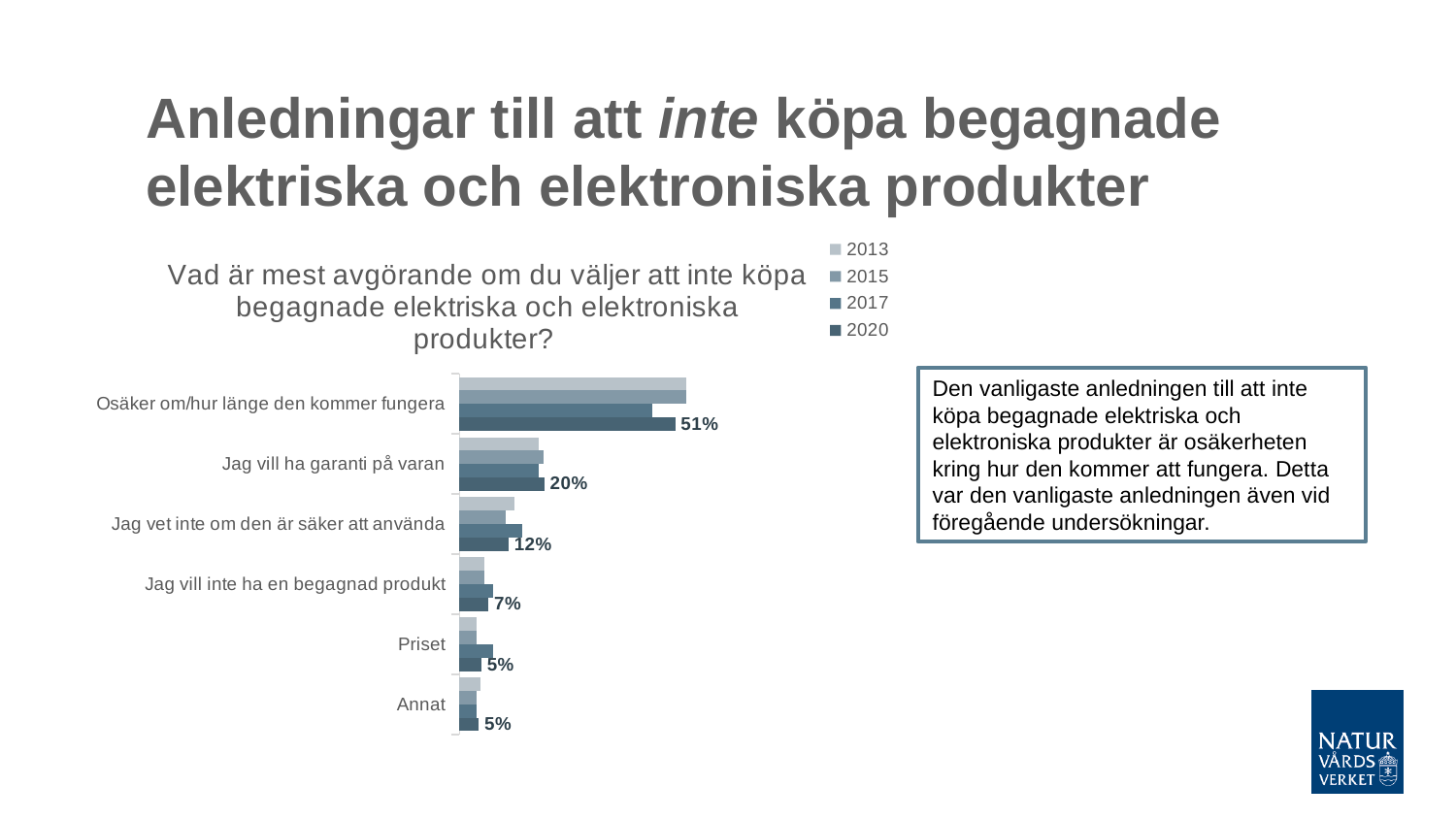
What is the 2020 value for "Priset"? 5% Which category has the highest 2020 value? Osäker om/hur länge den kommer fungera What is the 2020 value for "Jag vet inte om den är säker att använda"? 12% What is the 2020 value for "Osäker om/hur länge den kommer fungera"? 51% How many categories are shown in the chart? 6 What kind of chart is shown on the slide? Bar chart Which has the larger 2020 value, "Jag vill ha garanti på varan" or "Jag vill inte ha en begagnad produkt"? Jag vill ha garanti på varan How many series does the legend list? 4 What is the difference between the 2020 values for "Osäker om/hur länge den kommer fungera" and "Jag vill ha garanti på varan"? 31% What is the difference between the 2020 values for "Jag vet inte om den är säker att använda" and "Jag vill inte ha en begagnad produkt"? 5% Which years are listed in the chart legend? 2013, 2015, 2017, 2020 What is the 2020 value for "Jag vill ha garanti på varan"? 20%